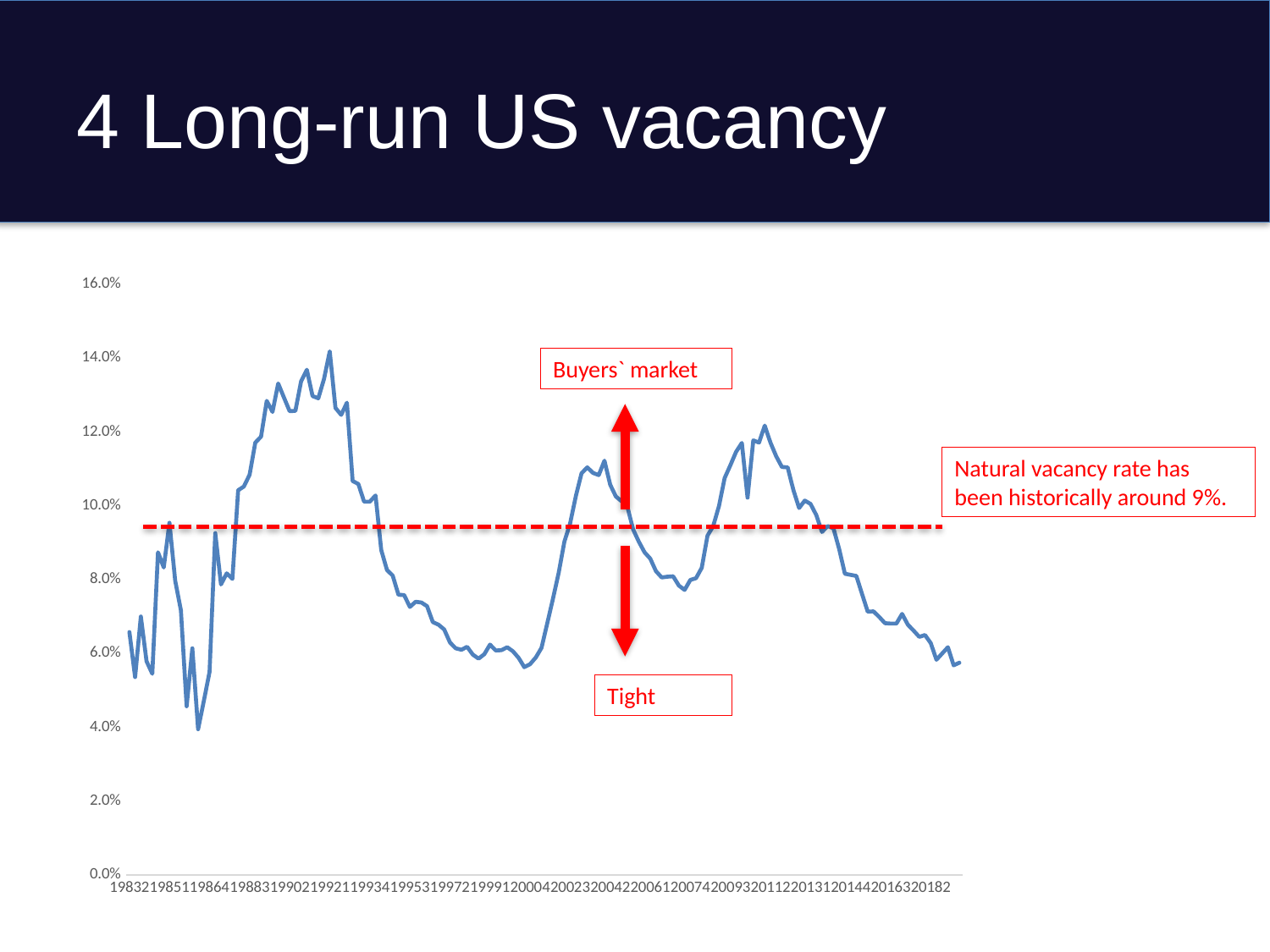
What is the highest value shown on the vertical axis? 16.0% Is the lowest point of the vacancy rate line in the mid-1980s greater or less than 6.0%? less According to the annotation on the slide, around what level has the natural vacancy rate historically been? around 9% Is the early-1990s peak of the line higher or lower than the peak around 2010? higher Is the vacancy rate around 2000 greater or less than 8.0%? less Is the vacancy rate at the right-hand end of the line (2018) greater or less than 8.0%? less What kind of chart is shown on the slide? line chart Does the vacancy rate line rise or fall over the final years shown (from about 2010 to 2018)? fall Does the vacancy rate line rise or fall between the mid-1980s and the early 1990s peak? rise Which label is placed above the red dashed line: 'Buyers` market' or 'Tight'? Buyers` market